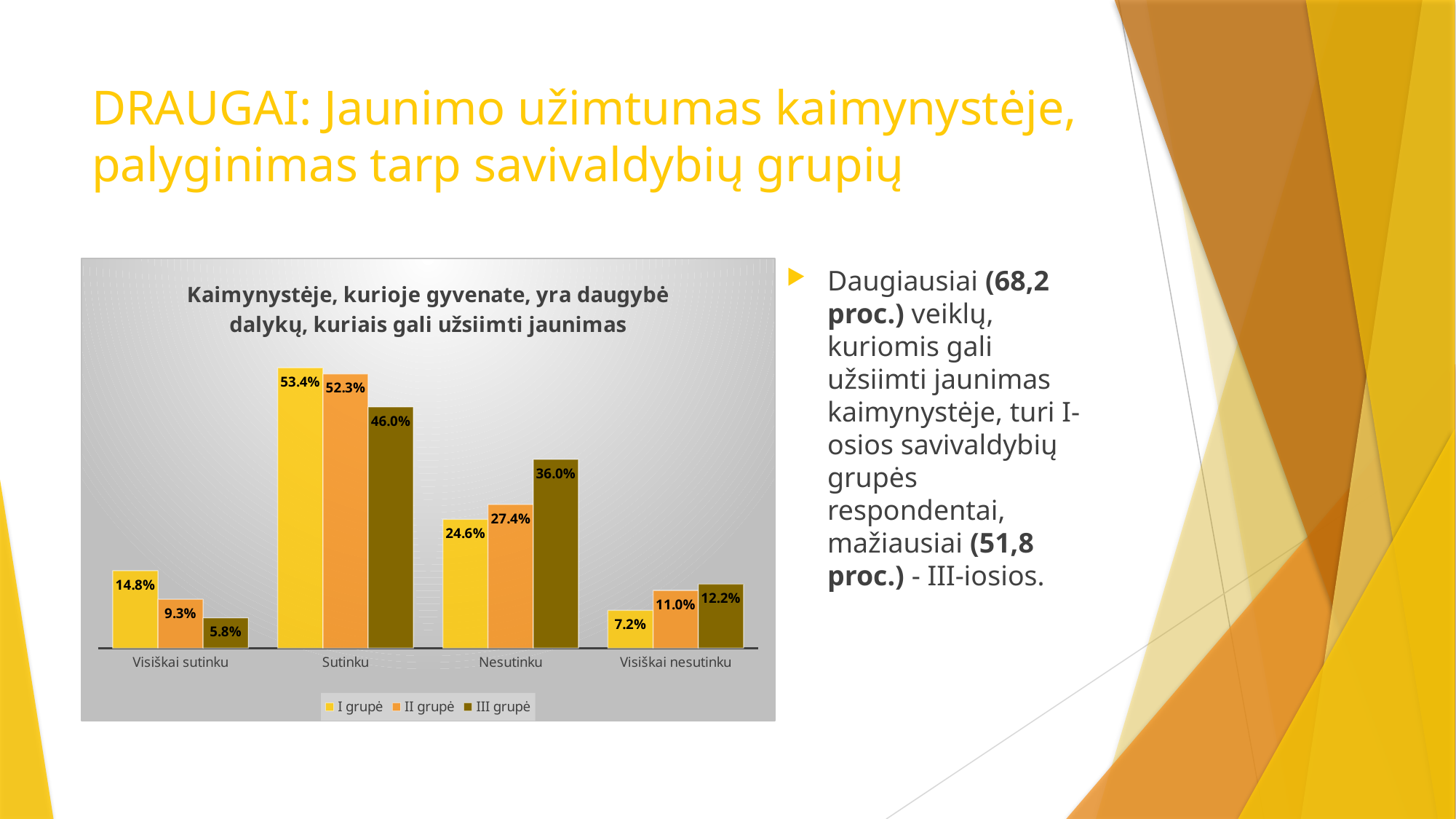
What is the value for III grupė in the Nesutinku category? 36.0% What is the value for I grupė in the Sutinku category? 53.4% What is the difference between II grupė and I grupė in the Nesutinku category? 2.8% What kind of chart is shown on the slide? Bar chart What is the title of the chart? Kaimynystėje, kurioje gyvenate, yra daugybė dalykų, kuriais gali užsiimti jaunimas What is the value for II grupė in the Visiškai sutinku category? 9.3% Which is larger in the Visiškai nesutinku category: II grupė or III grupė? III grupė What is the difference between I grupė and III grupė in the Sutinku category? 7.4% Which category has the lowest value for III grupė? Visiškai sutinku Which category has the highest value for I grupė? Sutinku How many categories are shown on the x axis? 4 How many series does the legend list? 3